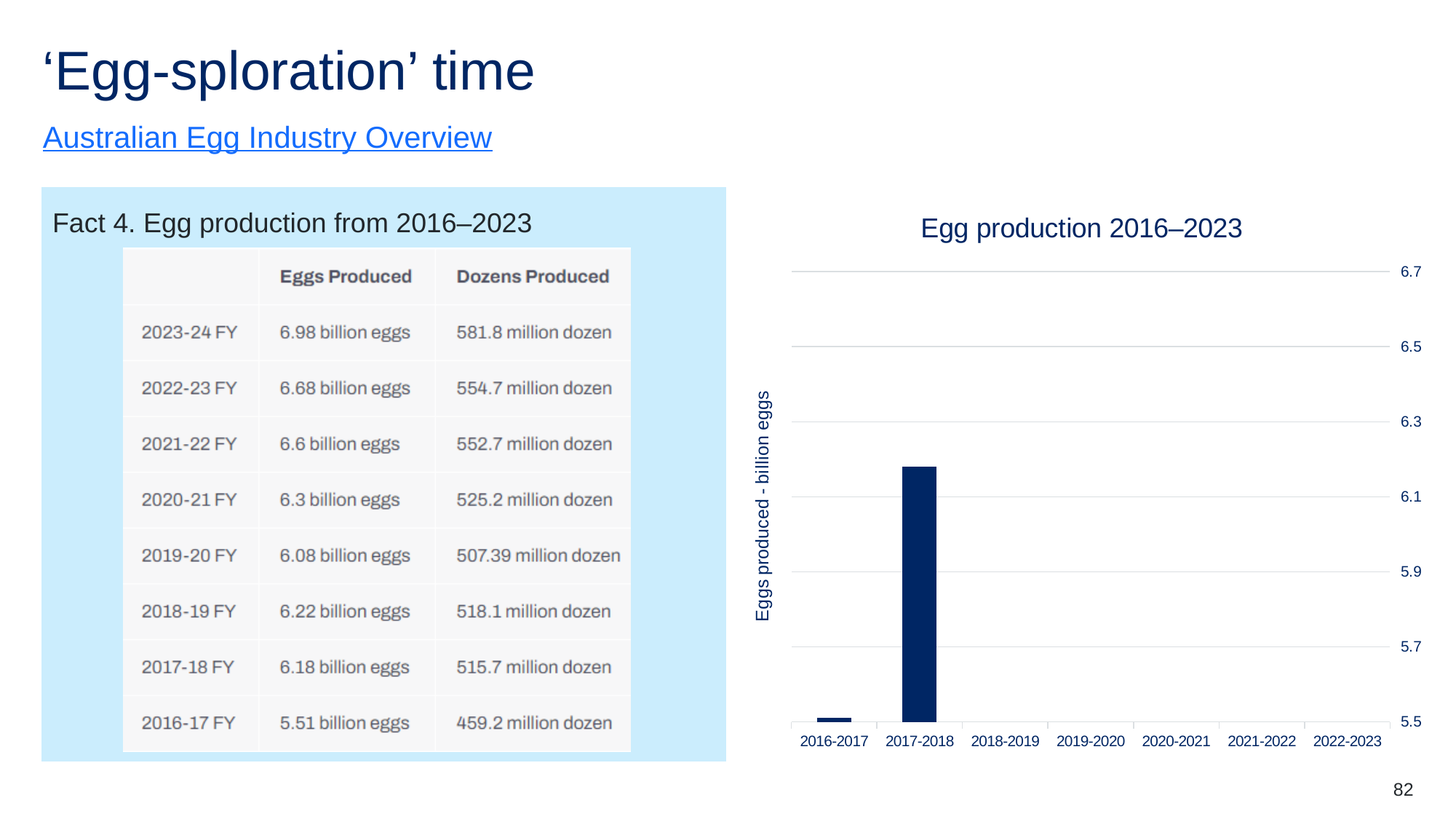
What kind of chart is shown under the title 'Egg production 2016–2023'? bar chart How many categories are labelled on the x axis of the 'Egg production 2016–2023' chart? 7 In the 'Egg production 2016–2023' chart, is the value for 2017-2018 greater or less than 6.1? greater In the 'Egg production 2016–2023' chart, which of the plotted bars is the lowest? 2016-2017 What is the highest tick value shown on the y axis of the 'Egg production 2016–2023' chart? 6.7 In the 'Egg production 2016–2023' chart, is the value for 2016-2017 greater or less than 5.7? less What is the y-axis title of the 'Egg production 2016–2023' chart? Eggs produced - billion eggs In the 'Egg production 2016–2023' chart, which bar is taller, 2016-2017 or 2017-2018? 2017-2018 In the 'Egg production 2016–2023' chart, does the value rise or fall from 2016-2017 to 2017-2018? rise In the 'Egg production 2016–2023' chart, is the value for 2017-2018 greater or less than 6.3? less In the 'Egg production 2016–2023' chart, which of the plotted bars is the highest? 2017-2018